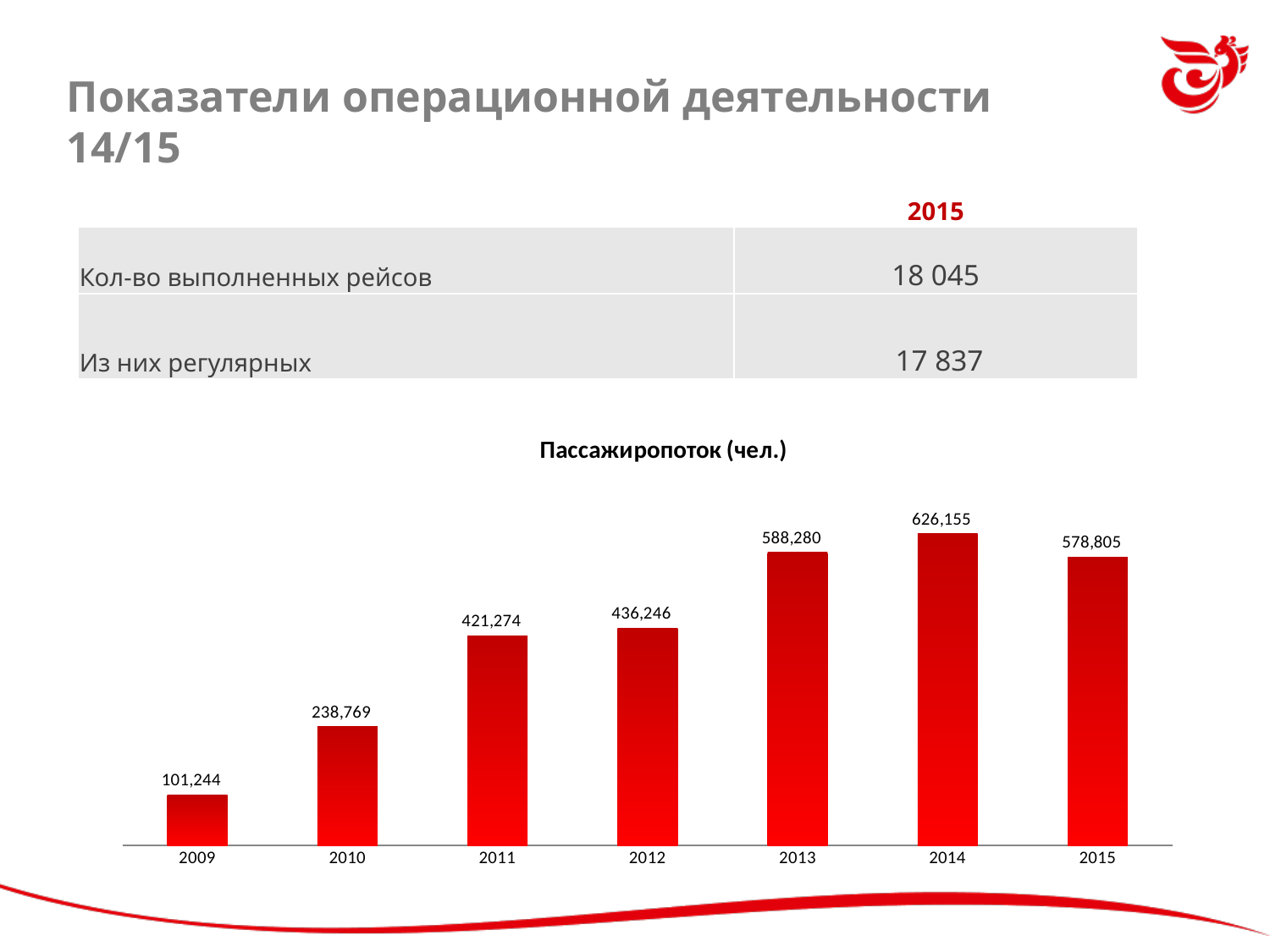
Which year has the highest passenger traffic in the Пассажиропоток (чел.) chart? 2014 What is the passenger traffic value for 2013 in the Пассажиропоток (чел.) chart? 588,280 How many years are shown on the x axis of the Пассажиропоток (чел.) chart? 7 What is the passenger traffic value for 2009 in the Пассажиропоток (чел.) chart? 101,244 Which year has higher passenger traffic in the Пассажиропоток (чел.) chart, 2013 or 2015? 2013 Which year has the lowest passenger traffic in the Пассажиропоток (чел.) chart? 2009 What is the title of the chart on the slide? Пассажиропоток (чел.) What type of chart is the Пассажиропоток (чел.) chart? Bar chart What is the passenger traffic value for 2015 in the Пассажиропоток (чел.) chart? 578,805 What is the difference in passenger traffic between 2010 and 2009 in the Пассажиропоток (чел.) chart? 137,525 Does passenger traffic rise or fall from 2009 to 2014 in the Пассажиропоток (чел.) chart? Rise By how much did passenger traffic decrease from 2014 to 2015 in the Пассажиропоток (чел.) chart? 47,350